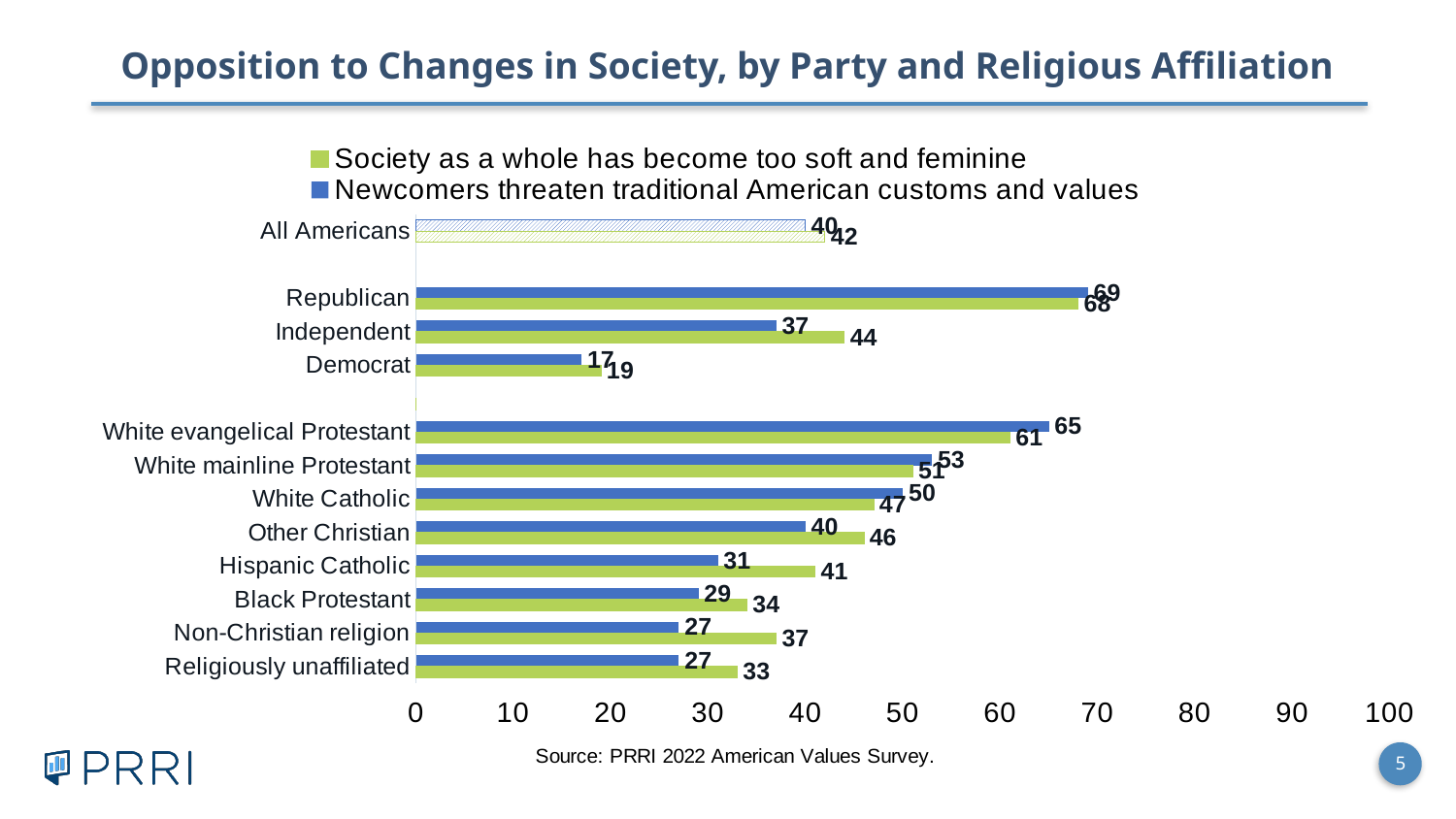
What is the value for Republican for the series "Newcomers threaten traditional American customs and values"? 69 What is the difference between the two series' values for Non-Christian religion? 10 What is the value for Hispanic Catholic for the series "Newcomers threaten traditional American customs and values"? 31 What is the value for All Americans for the series "Society as a whole has become too soft and feminine"? 42 What kind of chart is shown on the slide? Bar chart How many series does the legend list? 2 What is the difference between the "Newcomers threaten traditional American customs and values" values for White evangelical Protestant and Democrat? 48 Which category has the lowest value for the series "Society as a whole has become too soft and feminine"? Democrat What is the value for Independent for the series "Society as a whole has become too soft and feminine"? 44 Which category has the highest value for the series "Newcomers threaten traditional American customs and values"? Republican For Other Christian, which series has the larger value? Society as a whole has become too soft and feminine How many categories are shown on the chart? 12